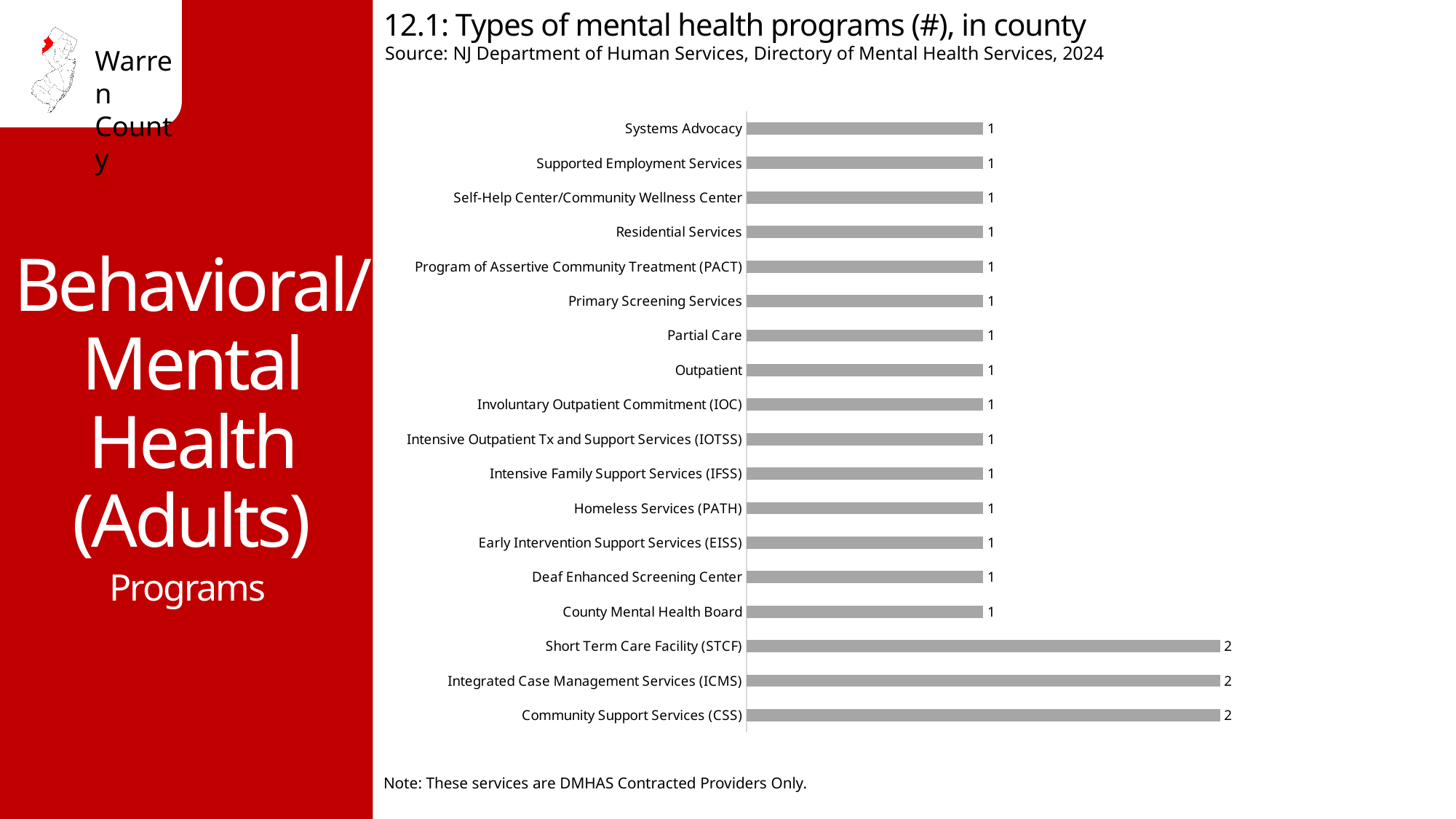
What is the difference between the value for Short Term Care Facility (STCF) and the value for Residential Services? 1 What is the value for Short Term Care Facility (STCF)? 2 What is the value for Integrated Case Management Services (ICMS)? 2 How many program types are listed in the chart? 18 What is the value for Partial Care? 1 What kind of chart is shown on the slide? bar chart Which is larger, the value for Outpatient or the value for Community Support Services (CSS)? Community Support Services (CSS) What is the value for Homeless Services (PATH)? 1 How many program types have a value of 2? 3 What colour are the bars in the chart? gray What is the value for Community Support Services (CSS)? 2 What is the title of the chart? 12.1: Types of mental health programs (#), in county